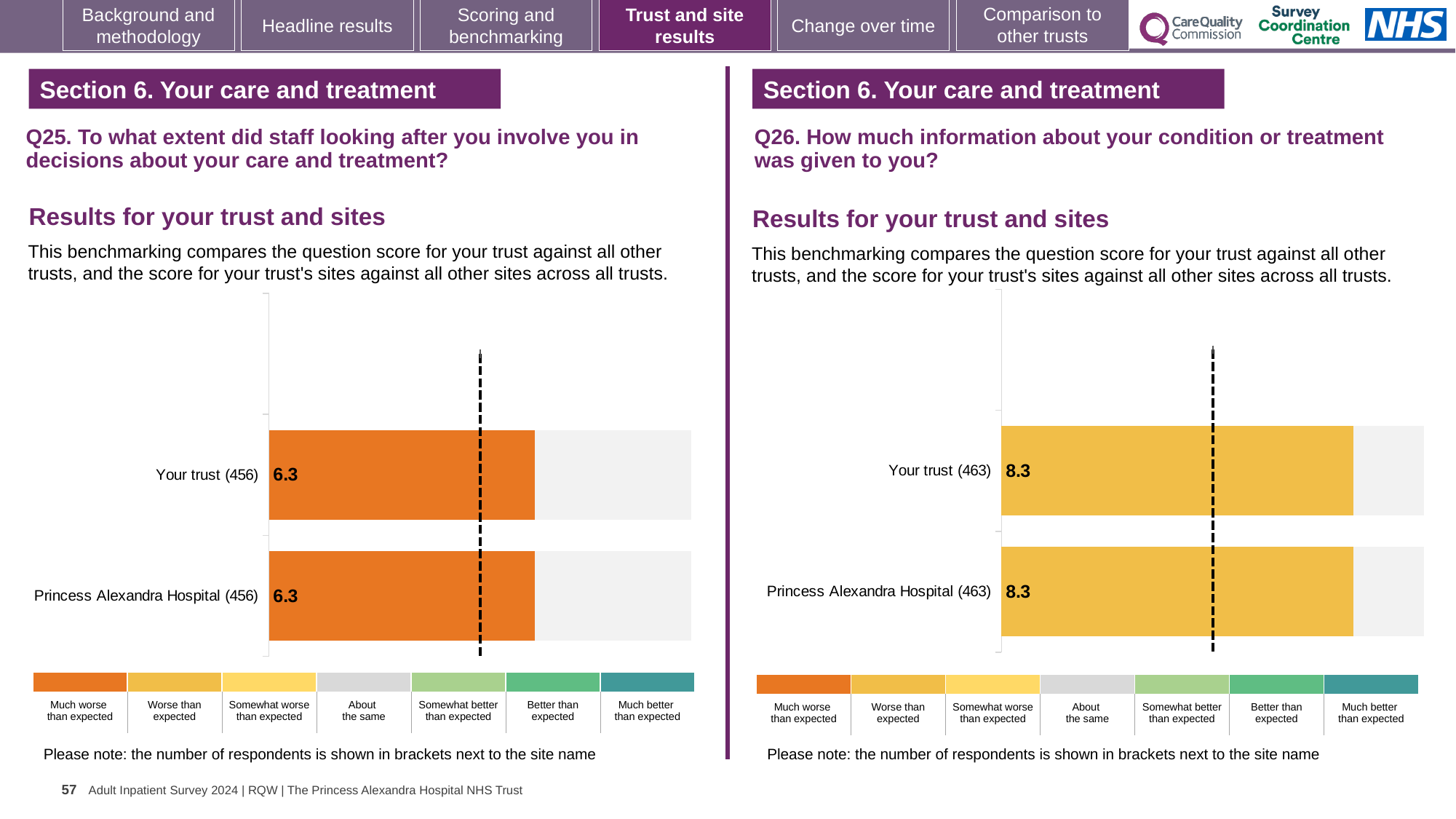
What kind of chart is the Q25 chart (left)? Bar chart On the Q26 chart (right), what is the score for Princess Alexandra Hospital? 8.3 On the Q25 chart (left), what is the score for Your trust? 6.3 On the Q25 chart (left), what is the score for Princess Alexandra Hospital? 6.3 On the Q25 chart (left), which benchmark category does the colour of the bars correspond to in the legend? Much worse than expected On the Q26 chart (right), what is the difference between the Your trust score and the Princess Alexandra Hospital score? 0.0 How many bars are plotted on the Q25 chart (left)? 2 How many bars are plotted on the Q26 chart (right)? 2 On the Q25 chart (left), how many respondents are shown in brackets for Your trust? 456 On the Q25 chart (left), what is the difference between the Your trust score and the Princess Alexandra Hospital score? 0.0 On the Q26 chart (right), how many respondents are shown in brackets for Princess Alexandra Hospital? 463 On the Q26 chart (right), what is the score for Your trust? 8.3